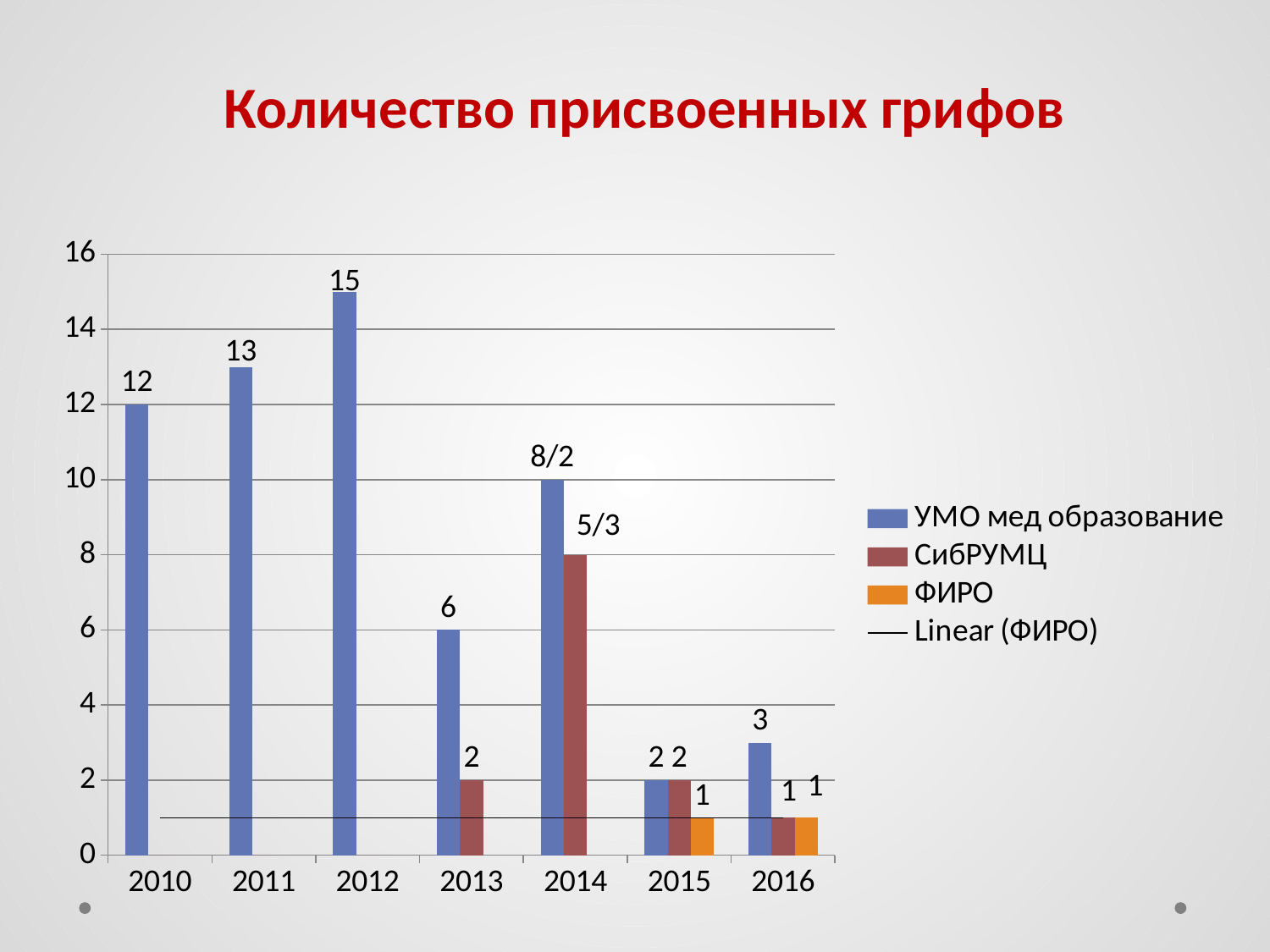
What is the title of the chart? Количество присвоенных грифов In 2013, which is larger: УМО мед образование or СибРУМЦ? УМО мед образование In which year is the УМО мед образование value highest? 2012 What is the value for УМО мед образование in 2012? 15 In which year is the УМО мед образование value lowest? 2015 How many years are shown on the x axis? 7 What is the value for ФИРО in 2015? 1 What is the value for УМО мед образование in 2010? 12 What is the value for СибРУМЦ in 2013? 2 What kind of chart is shown on the slide? bar chart How many entries does the legend list? 4 What is the difference between the УМО мед образование values for 2011 and 2010? 1